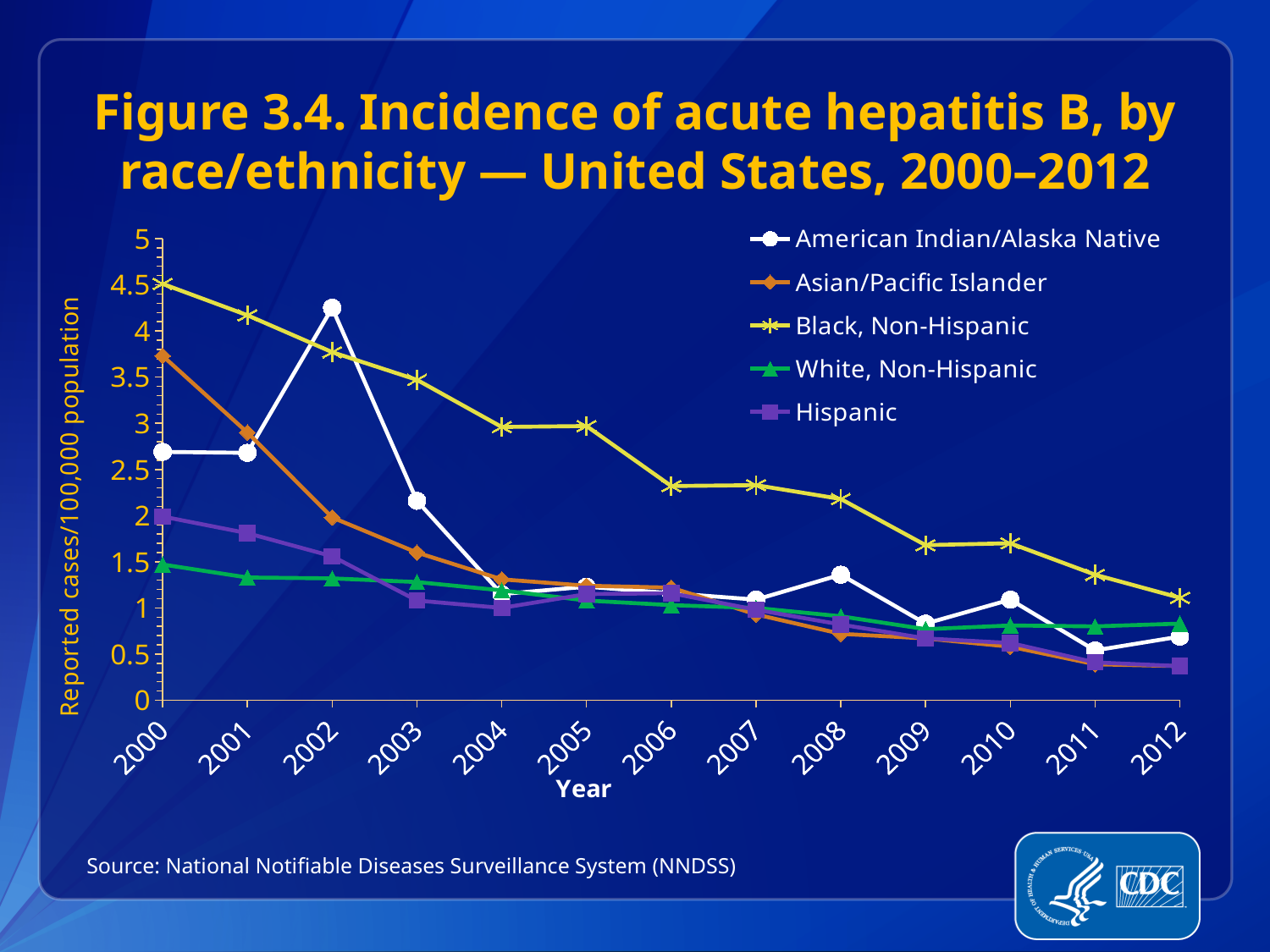
Is the value for American Indian/Alaska Native in 2002 greater or less than 4? greater How many years are plotted along the x axis? 13 How many series does the legend list? 5 Which race/ethnicity group had the highest incidence in 2000? Black, Non-Hispanic In 2000, which was larger: the value for Asian/Pacific Islander or for Hispanic? Asian/Pacific Islander What is the label on the y axis? Reported cases/100,000 population Which race/ethnicity group had the highest incidence in 2002? American Indian/Alaska Native Is the value for Asian/Pacific Islander in 2012 greater or less than 0.5? less Is the value for Black, Non-Hispanic in 2006 greater or less than 2? greater Does the incidence for Black, Non-Hispanic rise or fall from 2000 to 2012? fall What kind of chart is shown on the slide? line chart Which race/ethnicity group had the lowest incidence in 2000? White, Non-Hispanic